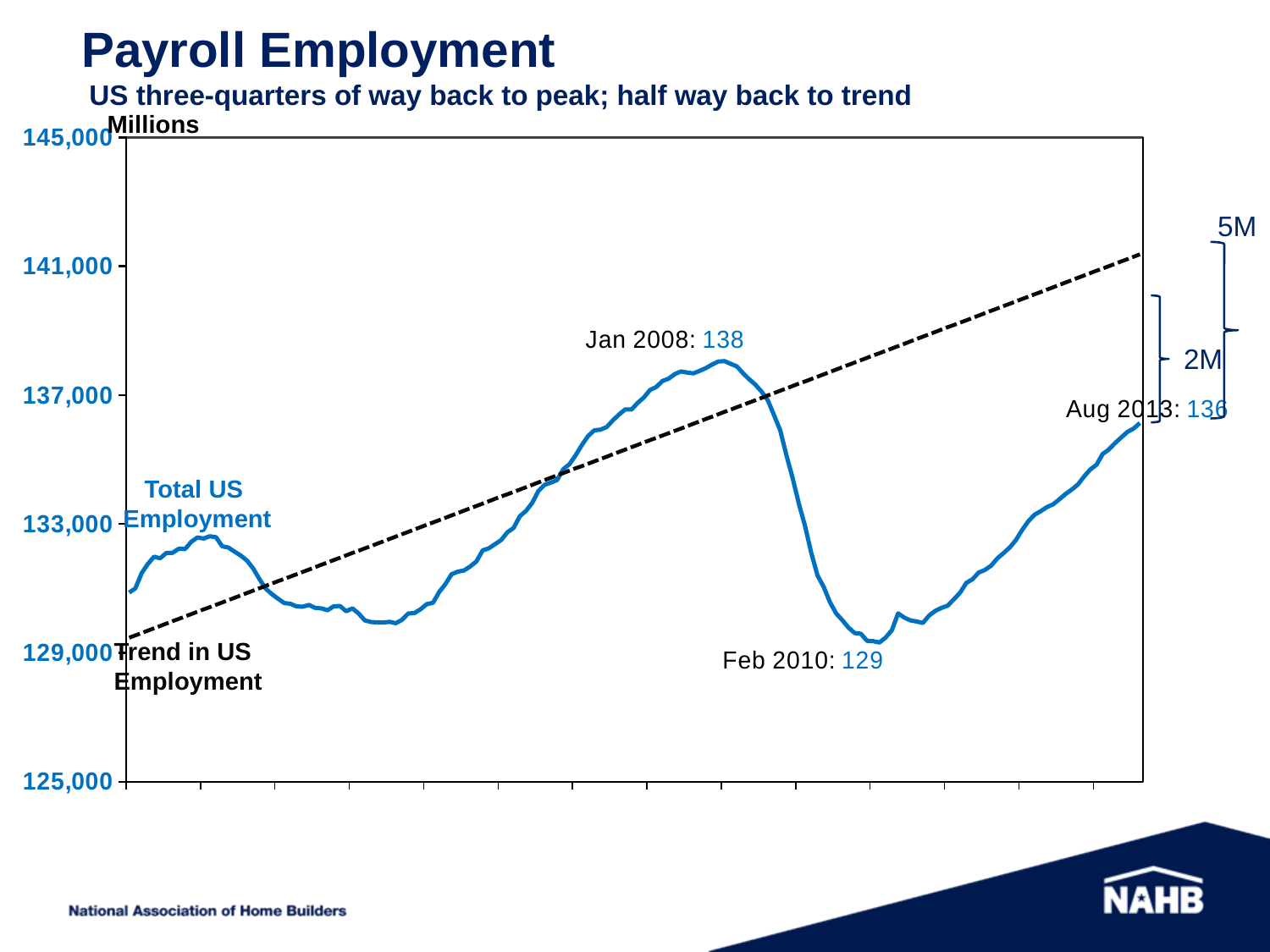
How does Total US Employment move between Feb 2010 and Aug 2013? rises What value is labeled for Total US Employment in Feb 2010? 129 Which labeled value is larger, Jan 2008 or Aug 2013? Jan 2008 What is the difference between the labeled Jan 2008 value and the labeled Feb 2010 value? 9 How many lines are plotted on the chart? 2 What value is labeled for Total US Employment in Aug 2013? 136 Of the three labeled points (Jan 2008, Feb 2010, Aug 2013), which has the lowest employment value? Feb 2010 What kind of chart is shown on the slide? line chart What value is labeled for Total US Employment in Jan 2008? 138 Is the Total US Employment line at its Jan 2008 peak greater or less than 137,000? greater Of the three labeled points (Jan 2008, Feb 2010, Aug 2013), which has the highest employment value? Jan 2008 What gap is labeled between the Aug 2013 employment level and the trend line? 5M